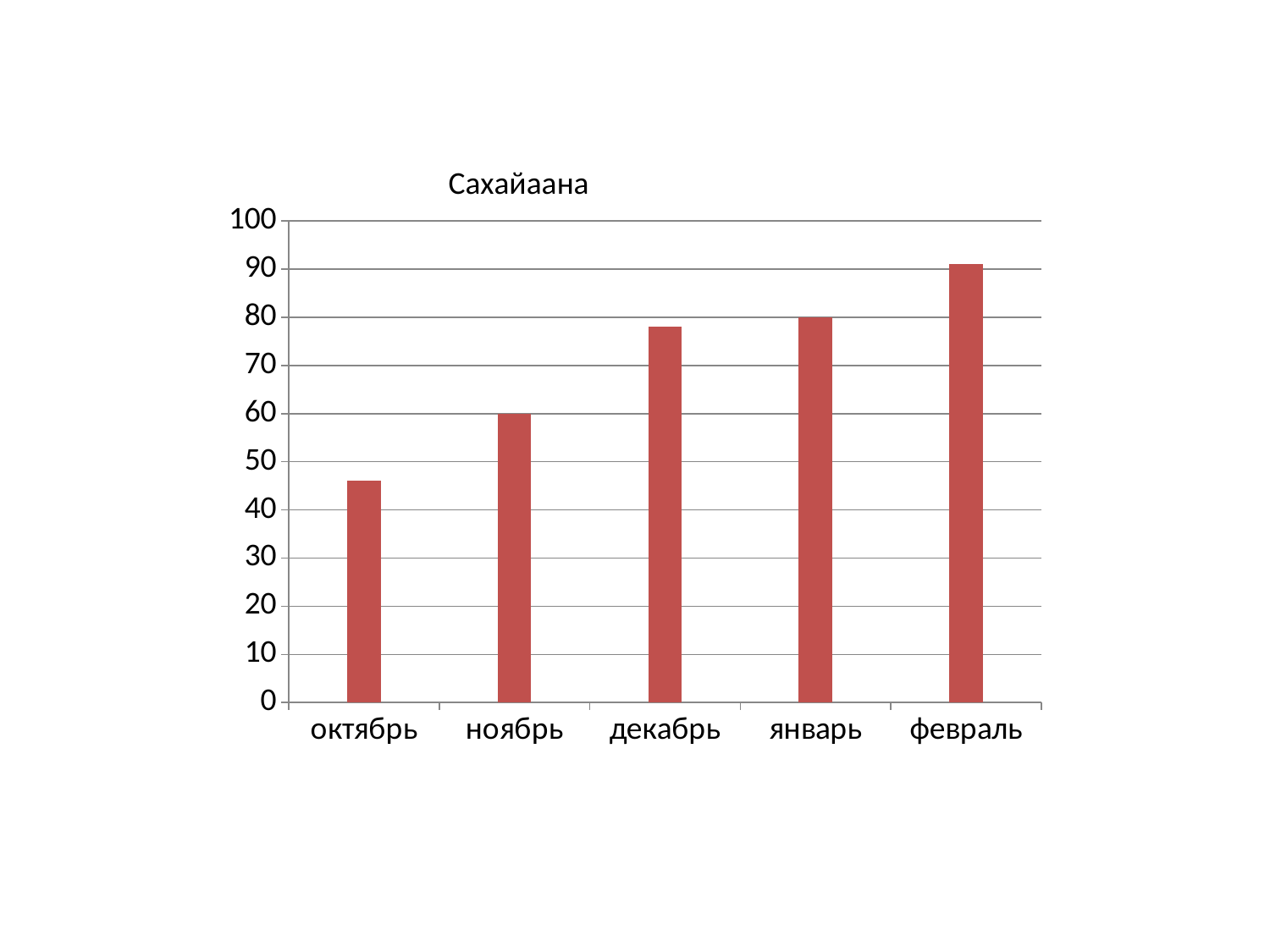
Is the value for октябрь greater or less than 50? less What is the title of the chart? Сахайаана Is the value for февраль greater or less than 80? greater How many categories are shown on the x axis of the chart? 5 Which month has the lowest value? октябрь What kind of chart is shown on the slide? bar chart What is the value for январь? 80 Do the values rise or fall from октябрь to февраль? rise Which month has the highest value? февраль What is the difference between the values for январь and ноябрь? 20 What is the value for ноябрь? 60 Which is larger, the value for декабрь or the value for ноябрь? декабрь